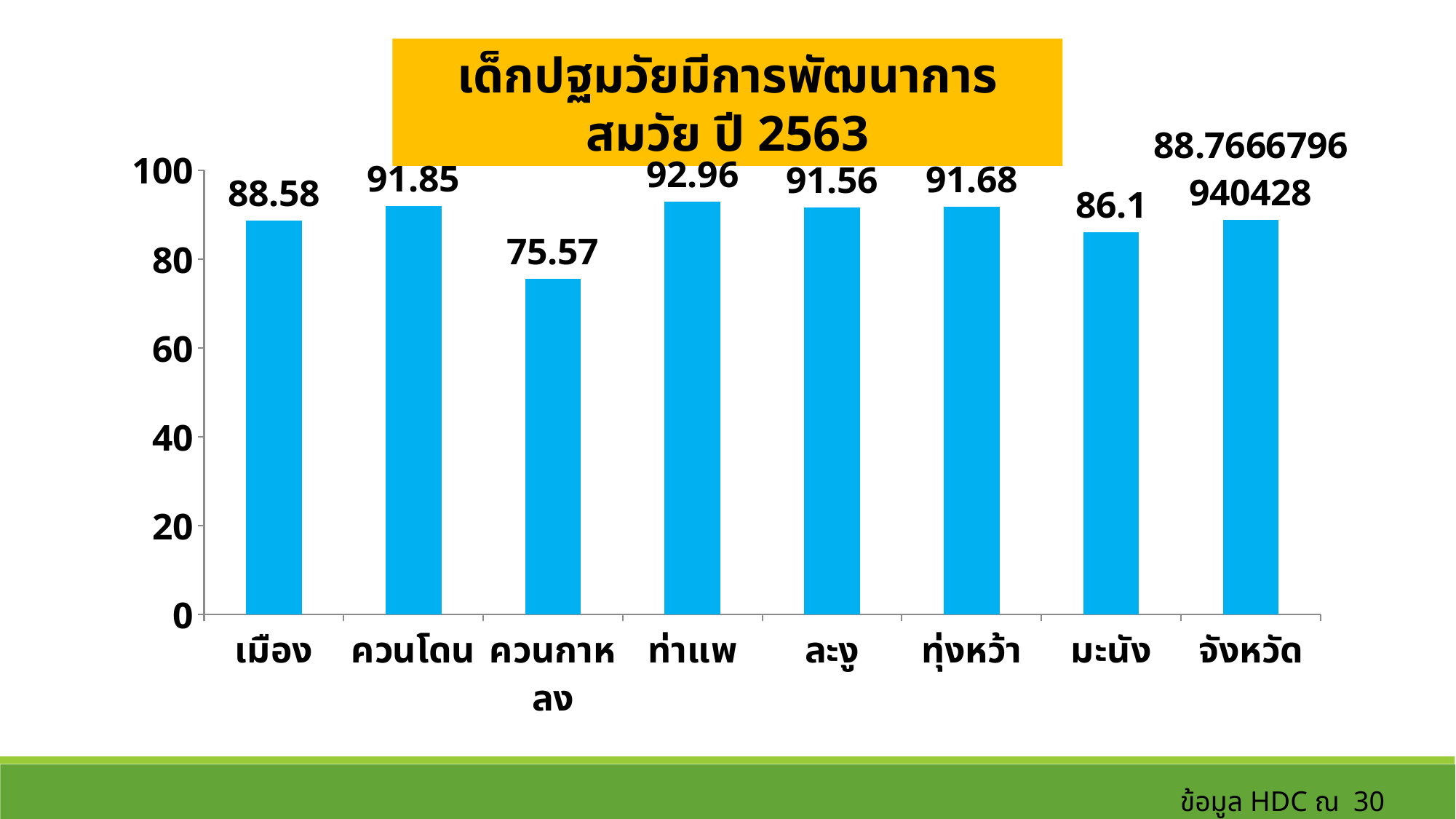
What is the value shown for จังหวัด? 88.7666796940428 Is the value for ควนกาหลง greater or less than 80? less Which is larger, the value for ควนโดน or the value for มะนัง? ควนโดน What is the value for เมือง? 88.58 What is the value for ควนกาหลง? 75.57 What is the value for มะนัง? 86.1 What is the difference between the values for ท่าแพ and ควนกาหลง? 17.39 How many categories are shown on the x axis? 8 Which category has the lowest value? ควนกาหลง Which category has the highest value? ท่าแพ What is the title of the chart? เด็กปฐมวัยมีการพัฒนาการสมวัย ปี 2563 What kind of chart is shown on the slide? bar chart